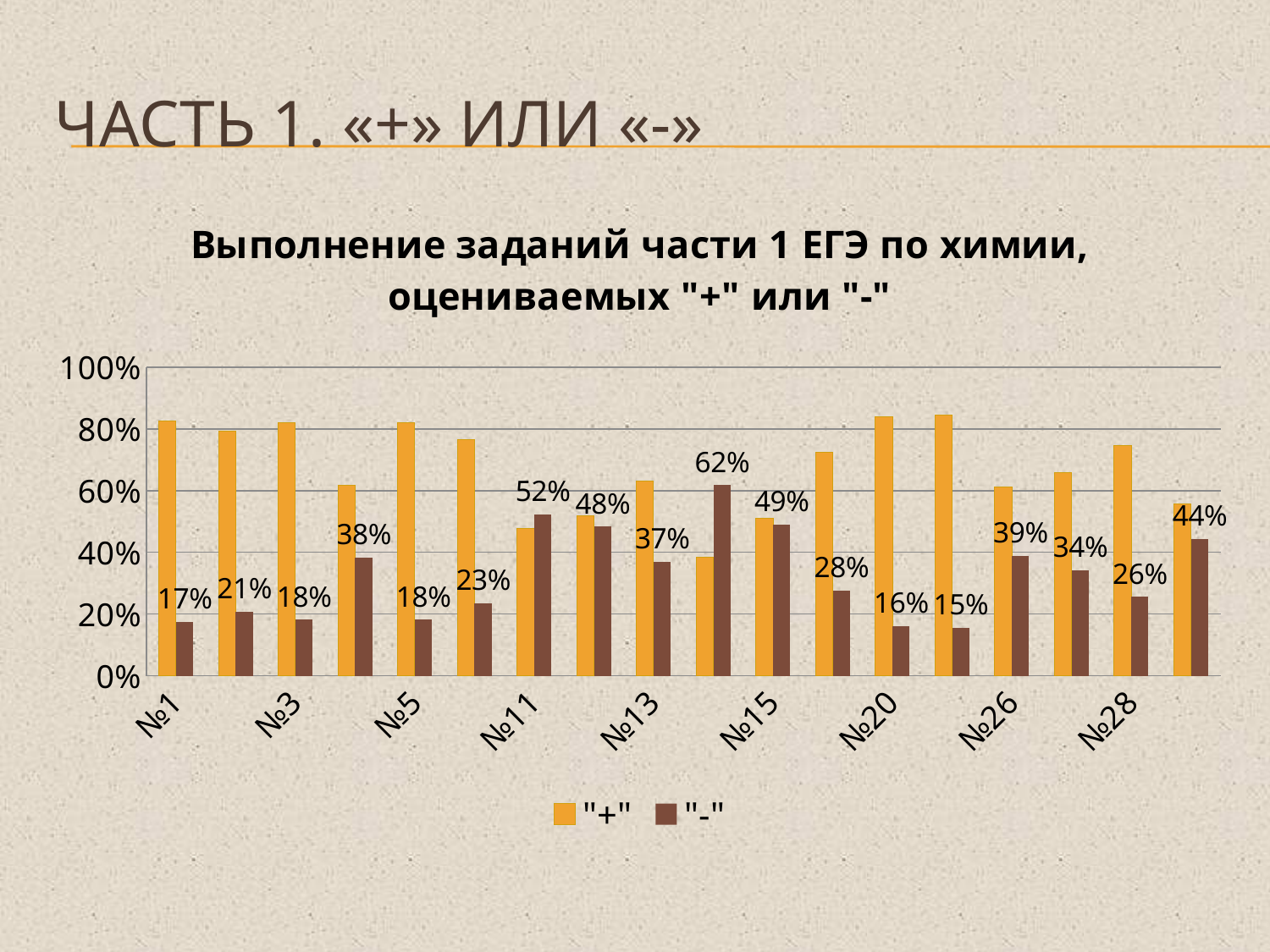
What is the highest value shown for the "-" series? 62% What kind of chart is shown on the slide? bar chart What is the lowest value shown for the "-" series? 15% Is the "+" value for task №20 greater or less than 80%? greater What is the title of the chart? Выполнение заданий части 1 ЕГЭ по химии, оцениваемых "+" или "-" How many series does the legend list? 2 What is the value of the "-" series for task №26? 39% What is the difference between the "-" values for task №11 and task №13? 15% What is the value of the "-" series for task №11? 52% Which is larger: the "-" value for task №15 or for task №28? №15 What is the value of the "-" series for task №20? 16% What is the value of the "-" series for task №1? 17%